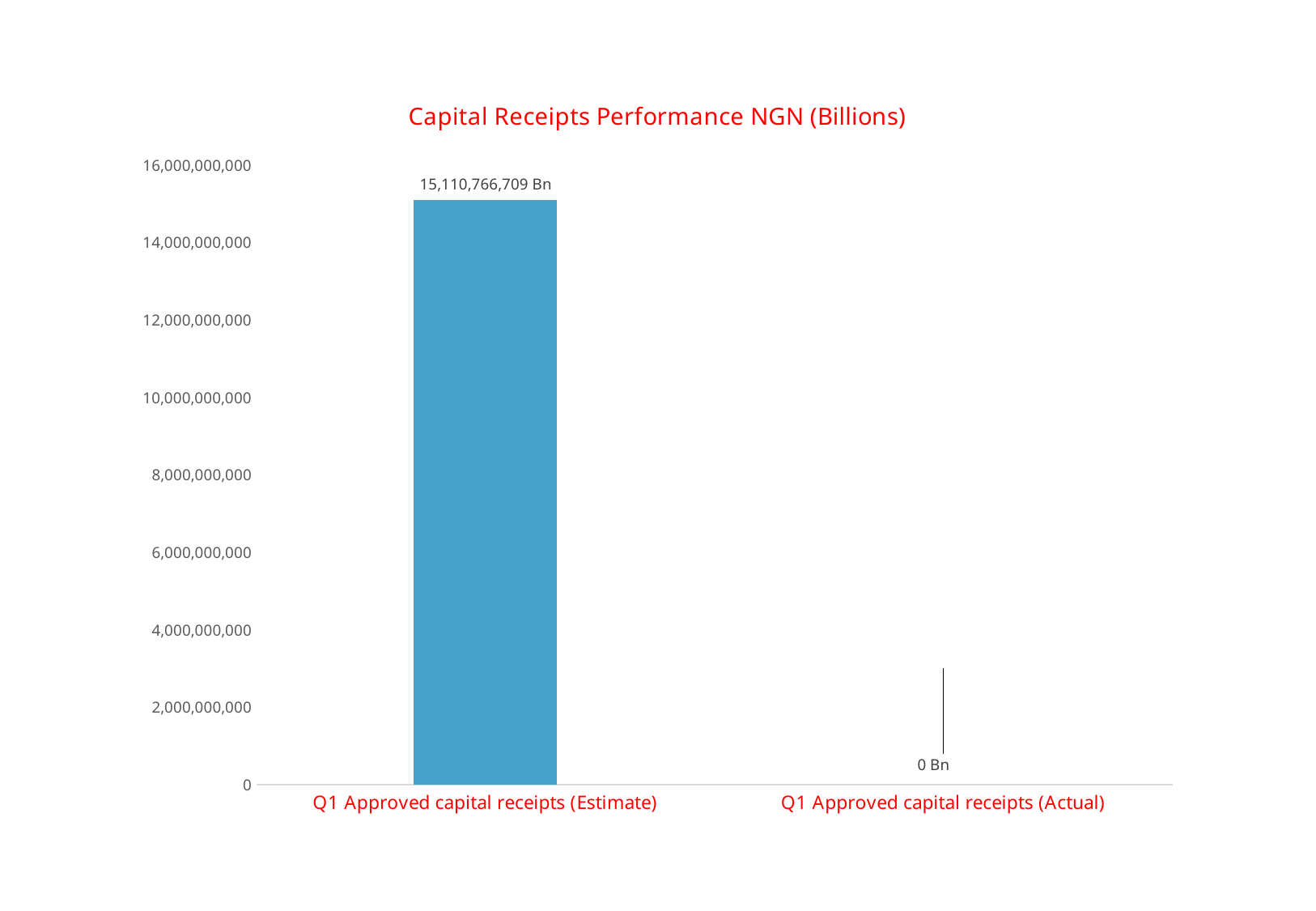
Is the value for Q1 Approved capital receipts (Estimate) greater or less than 14,000,000,000? greater What is the value for Q1 Approved capital receipts (Actual)? 0 Bn What kind of chart is shown? bar chart Do the values rise or fall from left to right along the x axis? fall Which category has the highest value? Q1 Approved capital receipts (Estimate) Is the value for Q1 Approved capital receipts (Estimate) greater or less than 16,000,000,000? less Which is larger, the Estimate or the Actual value? Q1 Approved capital receipts (Estimate) Which category has the lowest value? Q1 Approved capital receipts (Actual) What is the title of the chart? Capital Receipts Performance NGN (Billions) What is the value for Q1 Approved capital receipts (Estimate)? 15,110,766,709 Bn How many categories are shown on the x axis? 2